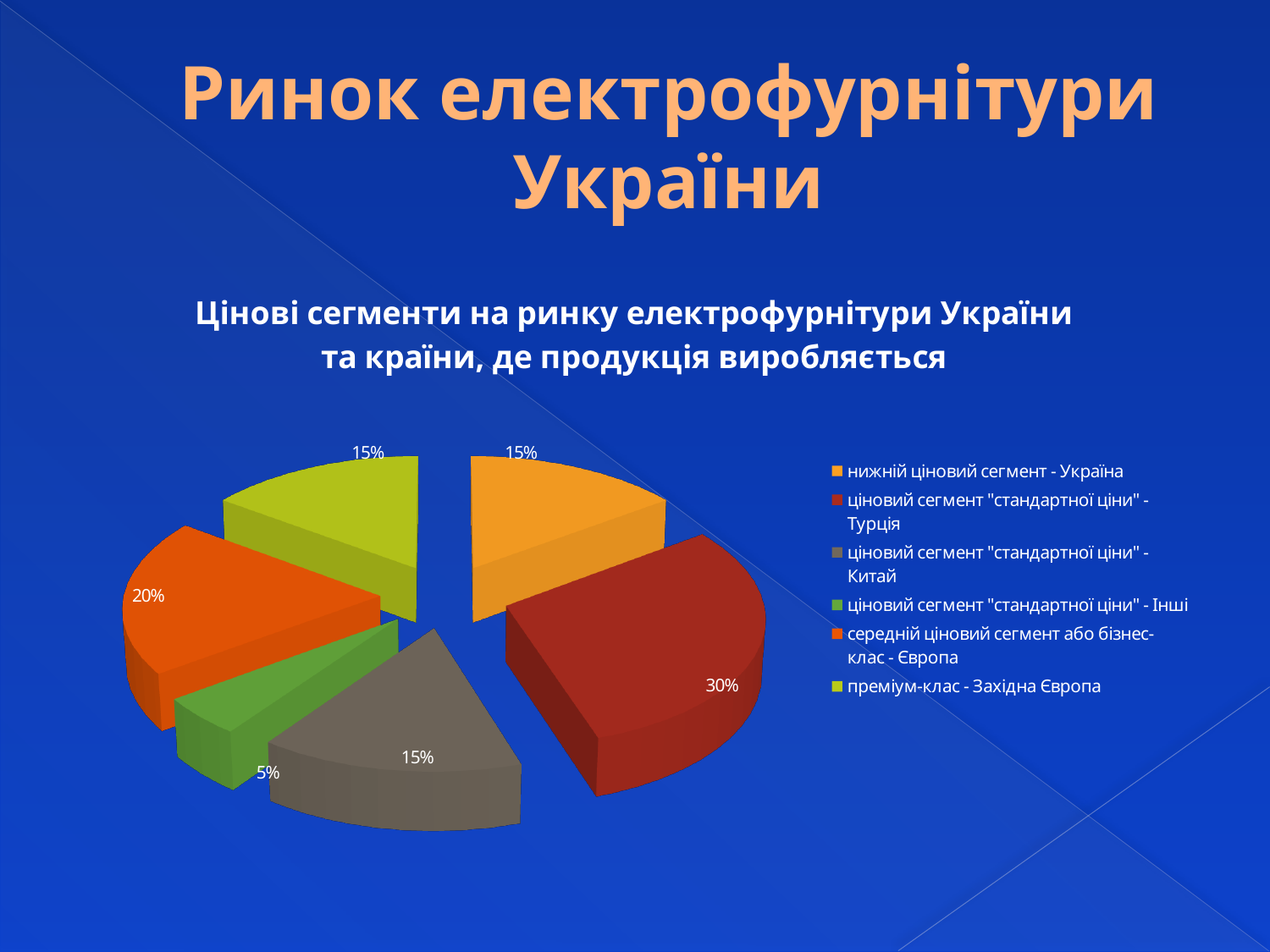
What share of the pie does the slice for середній ціновий сегмент або бізнес-клас - Європа represent? 20% How many slices does the pie chart have? 6 Which segment has the smallest slice of the pie? ціновий сегмент "стандартної ціни" - Інші What type of chart is shown on the slide? pie chart What share of the pie does the slice for нижній ціновий сегмент - Україна represent? 15% What is the title of the chart? Цінові сегменти на ринку електрофурнітури України та країни, де продукція виробляється What is the difference in percentage points between the Турція slice and the Європа slice? 10 What share of the pie does the slice for ціновий сегмент "стандартної ціни" - Турція represent? 30% Which is larger: the slice for середній ціновий сегмент або бізнес-клас - Європа or the slice for преміум-клас - Західна Європа? середній ціновий сегмент або бізнес-клас - Європа Which segment has the largest slice of the pie? ціновий сегмент "стандартної ціни" - Турція What share of the pie does the slice for ціновий сегмент "стандартної ціни" - Інші represent? 5% How many slices of the pie are labelled 15%? 3